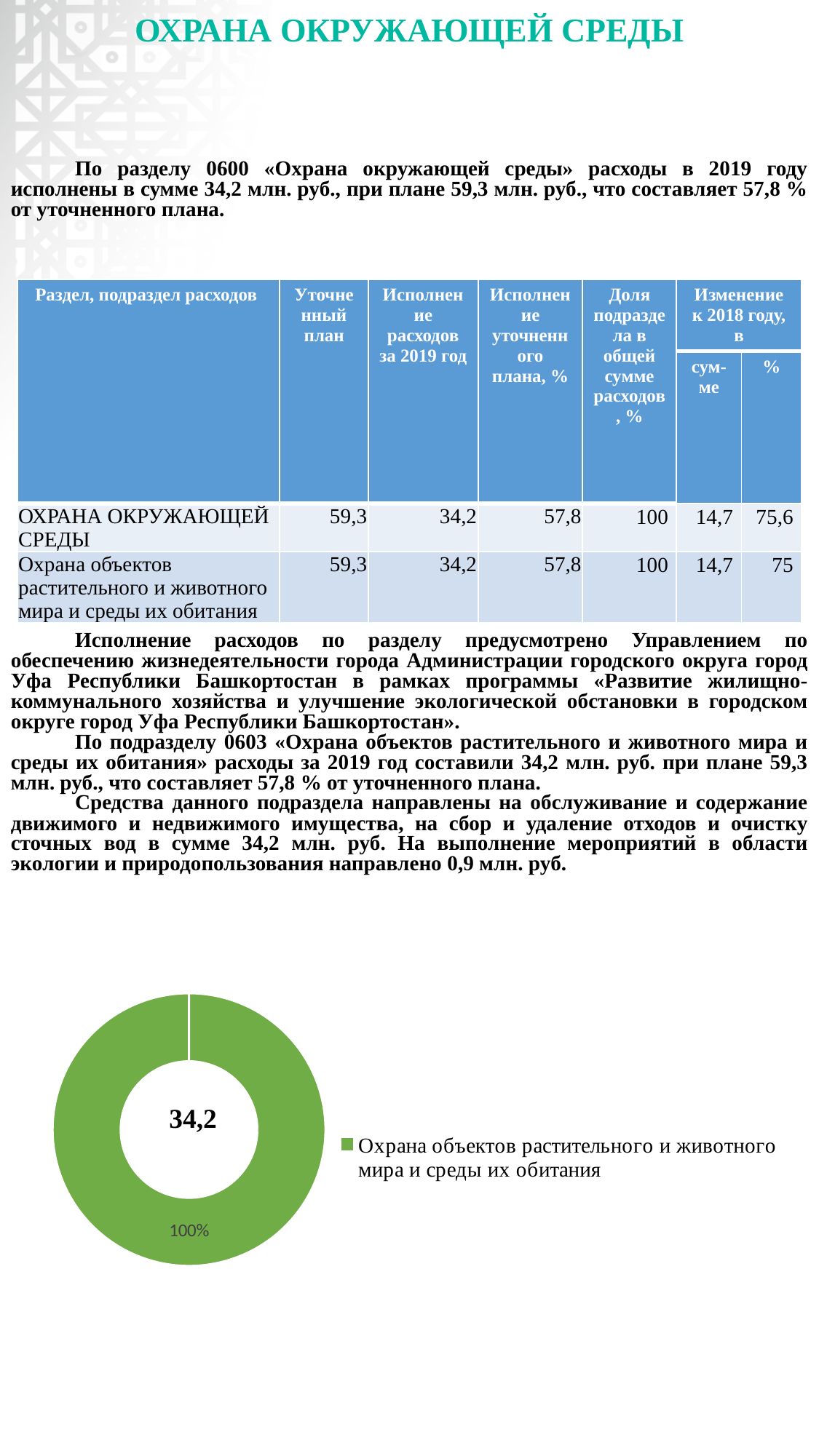
How many slices does the doughnut chart have? 1 What value is printed in the centre of the doughnut chart? 34,2 What is the name of the category shown in the legend of the doughnut chart? Охрана объектов растительного и животного мира и среды их обитания How many entries does the legend of the doughnut chart list? 1 What share of the doughnut chart does the slice "Охрана объектов растительного и животного мира и среды их обитания" take? 100% What kind of chart is shown at the bottom of the slide? Doughnut chart What percentage label is printed on the slice of the doughnut chart? 100% What colour is the slice of the doughnut chart? Green